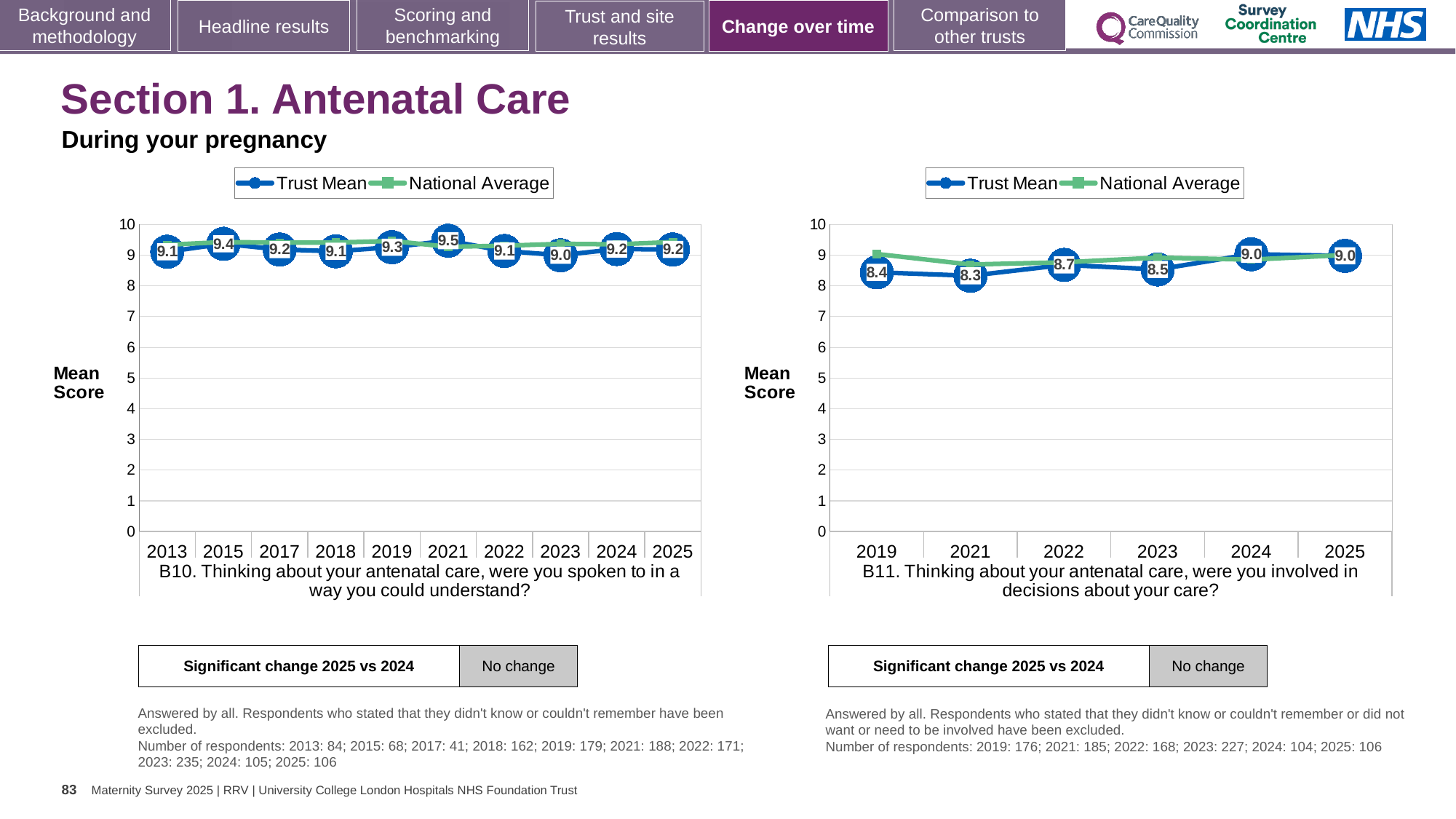
In the B10 chart, which year has the highest Trust Mean score? 2021 How many series does the legend of the B11 chart list? 2 In the B10 chart, what is the difference between the Trust Mean scores for 2021 and 2023? 0.5 How many years are plotted on the x axis of the B10 chart? 10 In the B10 chart, which year has the higher Trust Mean score, 2015 or 2018? 2015 In the B11 chart, what is the difference between the Trust Mean scores for 2025 and 2019? 0.6 In the B10 chart, which year has the lowest Trust Mean score? 2023 What kind of chart is used for the B11 question? Line chart In the B11 chart, is the National Average value for 2019 greater or less than 8? greater In the B11 chart, which year has the lowest Trust Mean score? 2021 In the B11 chart, what is the Trust Mean score for 2019? 8.4 In the B10 chart, what is the Trust Mean score for 2021? 9.5